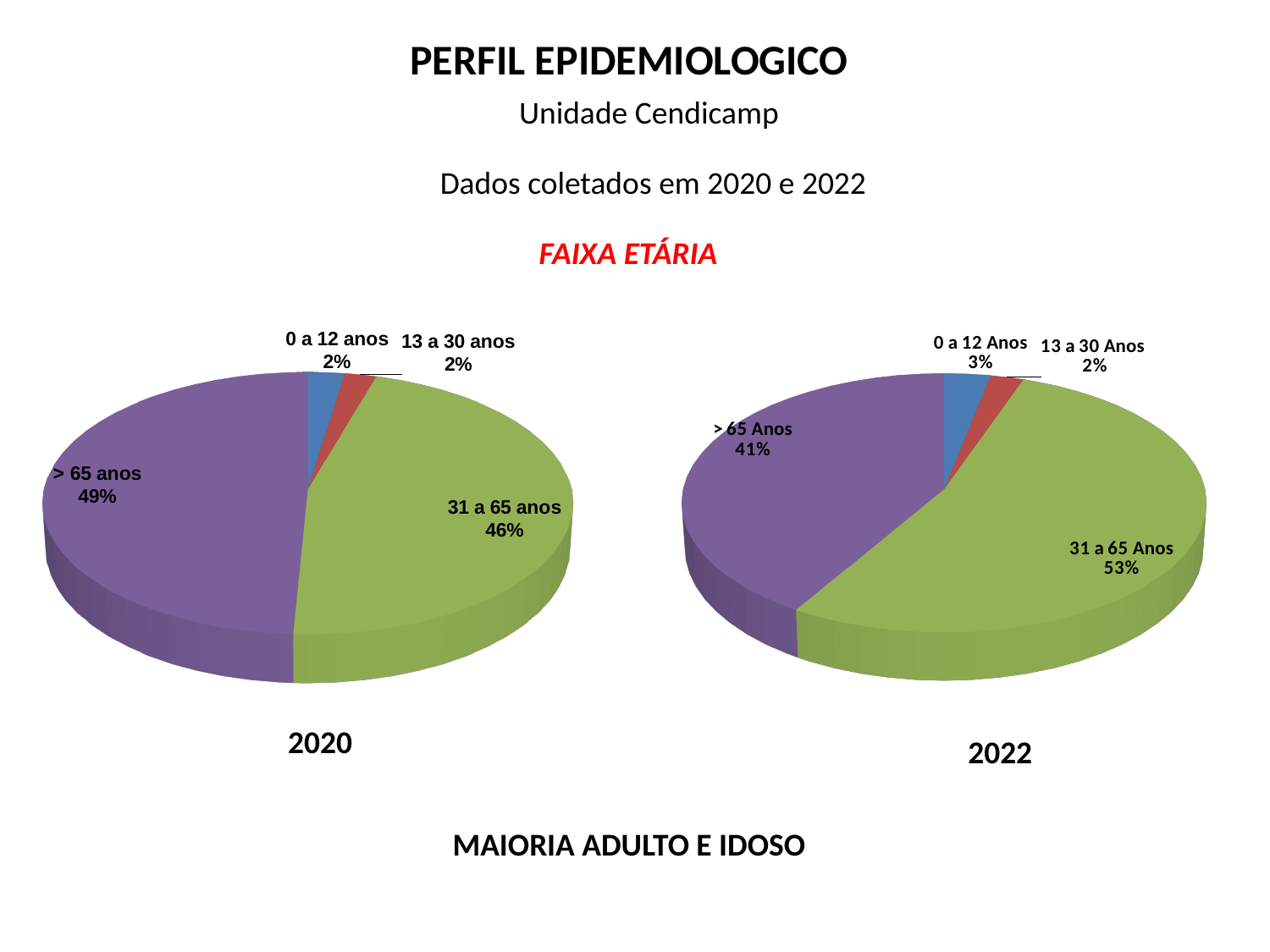
In the 2022 pie chart, which age group has the smallest slice? 13 a 30 Anos In the 2020 pie chart, which age group has the largest slice? > 65 anos How many slices does the 2020 pie chart have? 4 Which is larger: the '> 65 anos' share in the 2020 chart or the '> 65 Anos' share in the 2022 chart? 2020 In the 2022 pie chart, what is the difference in percentage points between the '31 a 65 Anos' slice and the '> 65 Anos' slice? 12 In the 2020 pie chart, what share is shown for the '> 65 anos' slice? 49% What type of chart is used for the 2022 data? Pie chart In the 2022 pie chart, which age group has the largest slice? 31 a 65 Anos In the 2020 pie chart, what share is shown for the '31 a 65 anos' slice? 46% In the 2022 pie chart, what share is shown for the '0 a 12 Anos' slice? 3% In the 2022 pie chart, what share is shown for the '> 65 Anos' slice? 41% In the 2022 pie chart, what share is shown for the '31 a 65 Anos' slice? 53%